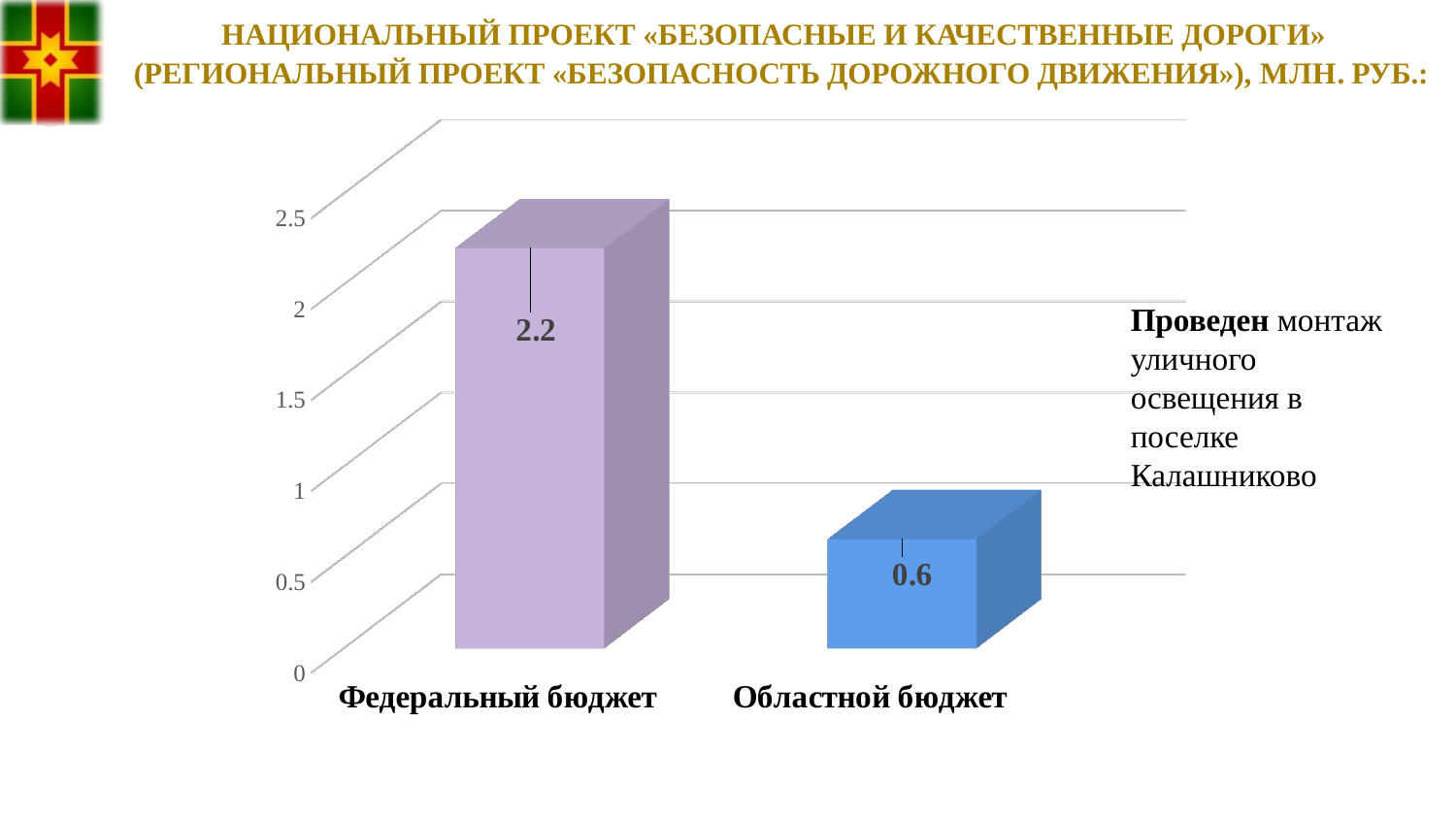
What is the value for Федеральный бюджет? 2.2 Is the value for Областной бюджет greater or less than 1? less In what units are the values in the chart expressed, according to the slide title? млн. руб. Which category has the lowest value? Областной бюджет Is the value for Федеральный бюджет greater or less than 2? greater What is the total of the two values shown in the chart? 2.8 How many categories are shown in the chart? 2 What kind of chart is shown on the slide? bar chart Which category has the highest value? Федеральный бюджет Which is larger, the value for Федеральный бюджет or the value for Областной бюджет? Федеральный бюджет What is the difference between the values for Федеральный бюджет and Областной бюджет? 1.6 What is the value for Областной бюджет? 0.6